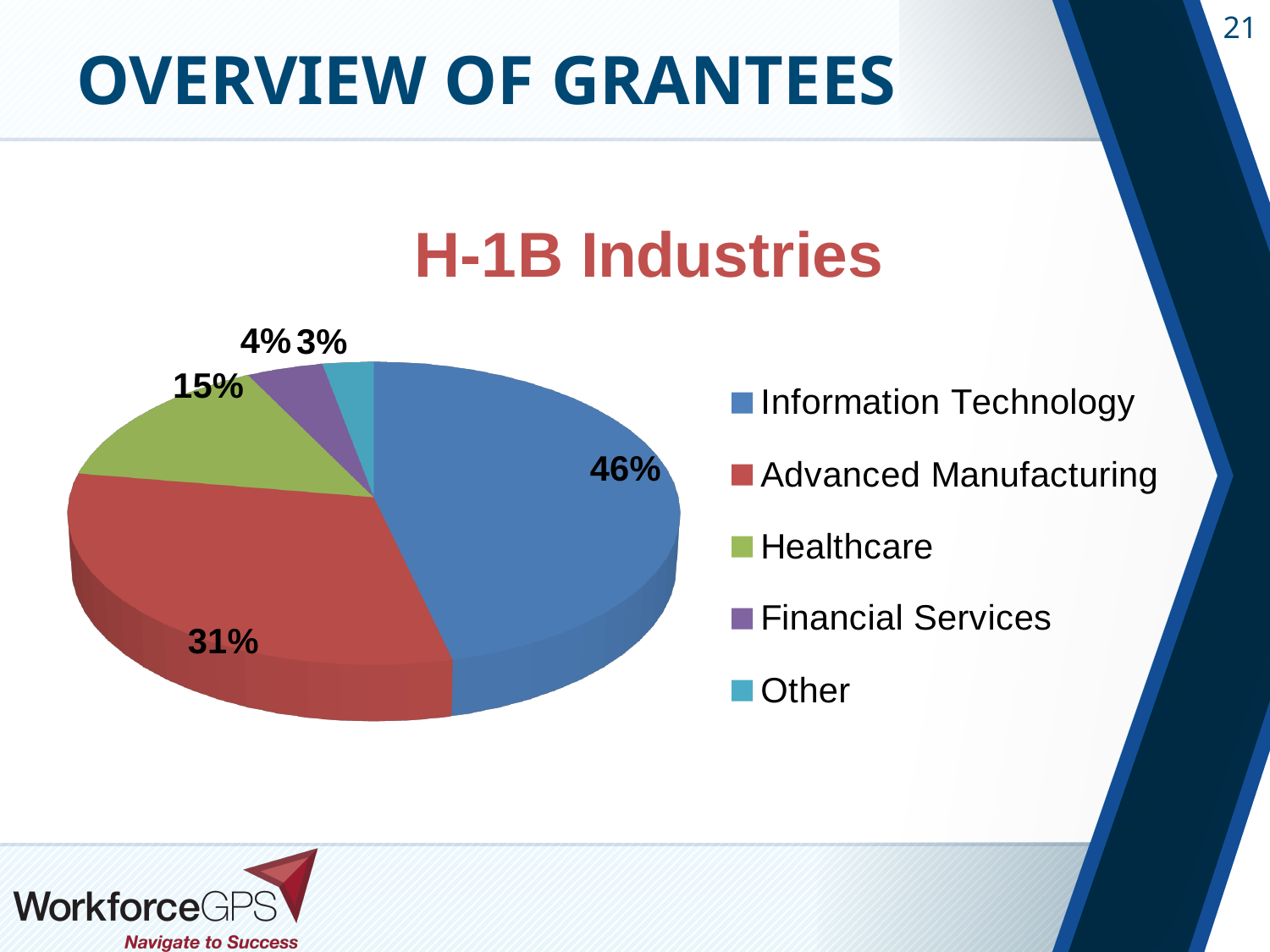
What is the title of the chart on the slide? H-1B Industries Which industry has the smallest slice of the H-1B Industries pie? Other What type of chart is shown on the slide? Pie chart What share of the H-1B Industries pie is Financial Services? 4% What share of the H-1B Industries pie is Healthcare? 15% Which industry has the largest slice of the H-1B Industries pie? Information Technology What share of the H-1B Industries pie is Advanced Manufacturing? 31% How many industries are shown in the H-1B Industries pie chart? 5 Which slice is larger, Healthcare or Financial Services? Healthcare How many percentage points larger is the Information Technology slice than the Advanced Manufacturing slice? 15